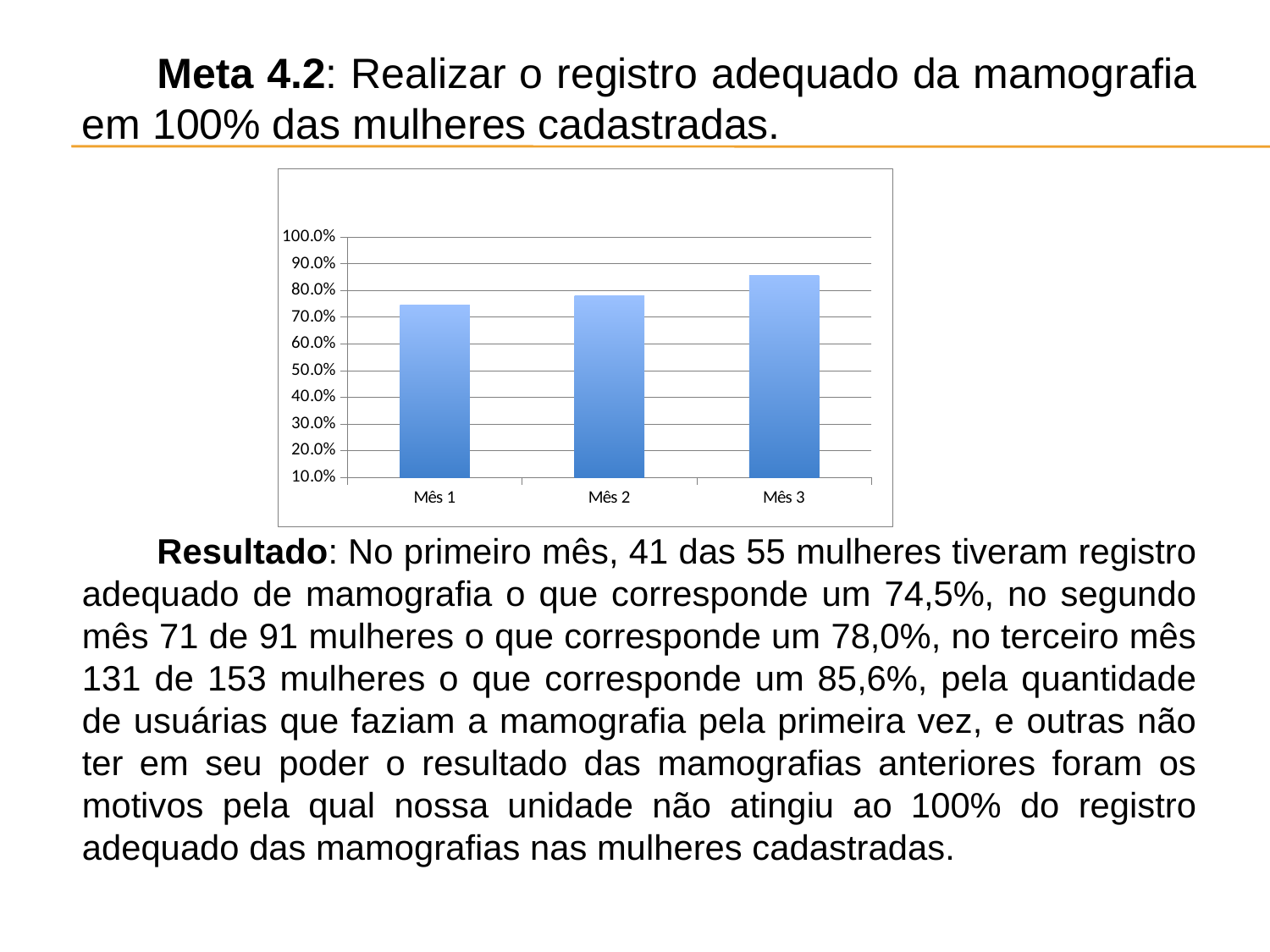
Which bar is taller, Mês 1 or Mês 2? Mês 2 Is the value for Mês 3 greater or less than 90.0%? less Which bar is taller, Mês 2 or Mês 3? Mês 3 What is the highest tick label shown on the chart's y axis? 100.0% Which month has the lowest bar in the chart? Mês 1 Is the value for Mês 3 greater or less than 80.0%? greater Is the value for Mês 1 greater or less than 70.0%? greater Do the bar values rise or fall from Mês 1 to Mês 3? Rise Which month has the highest bar in the chart? Mês 3 What kind of chart is shown on the slide? Bar chart How many categories (months) are shown on the x axis of the chart? 3